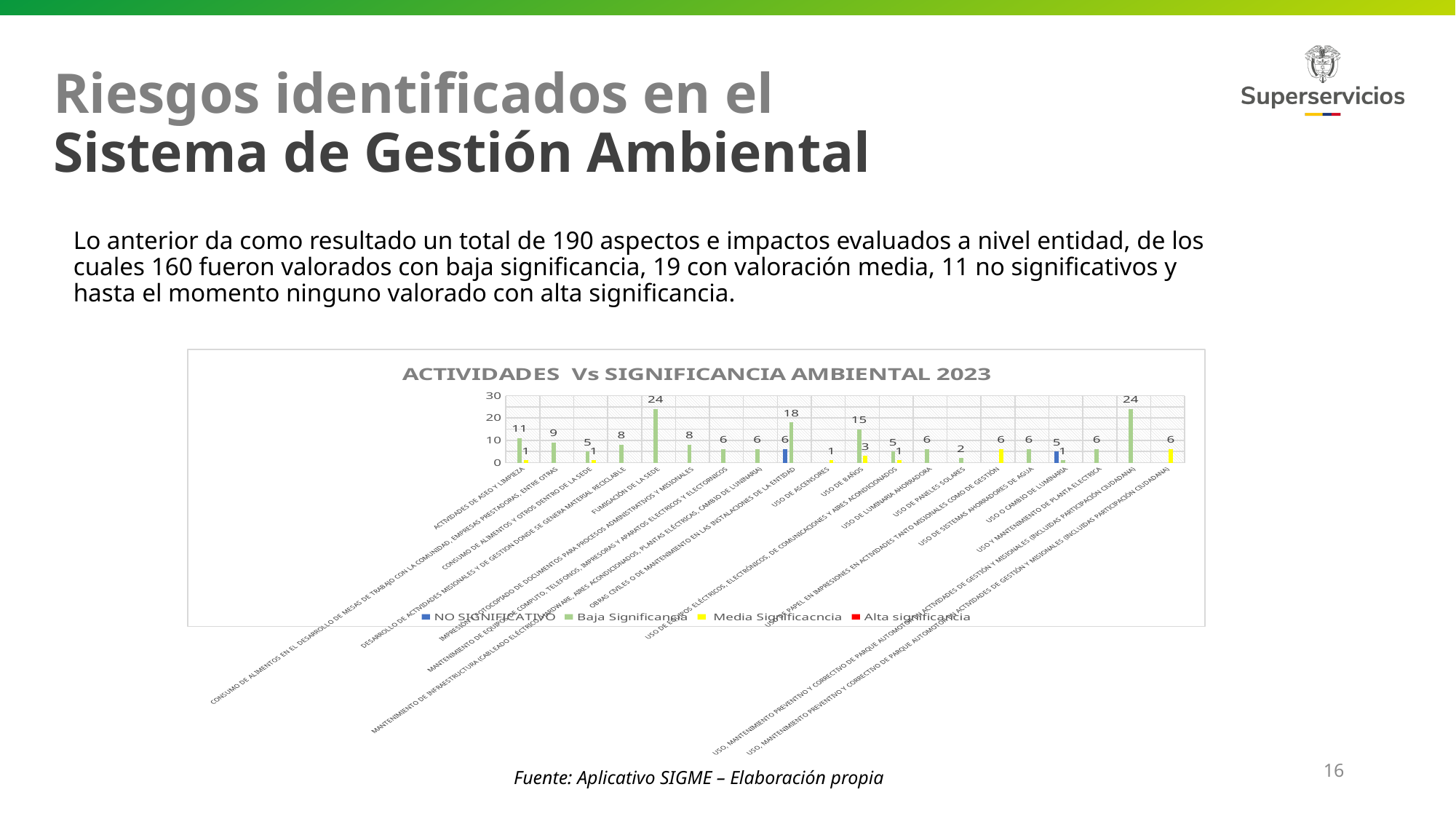
What type of chart is shown on the slide? Bar chart What is the title of the chart? ACTIVIDADES Vs SIGNIFICANCIA AMBIENTAL 2023 What is the Media Significacncia value for USO DE BAÑOS? 3 How many series does the chart legend list? 4 What is the Baja Significancia value for ACTIVIDADES DE ASEO Y LIMPIEZA? 11 What is the highest value labelled on the chart? 24 What is the Baja Significancia value for FUMIGACIÓN DE LA SEDE? 24 Which has a larger Baja Significancia value, FUMIGACIÓN DE LA SEDE or USO DE BAÑOS? FUMIGACIÓN DE LA SEDE What is the difference between the Baja Significancia and Media Significacncia values for USO DE BAÑOS? 12 What is the value shown for USO DE ASCENSORES? 1 What is the Baja Significancia value for USO DE BAÑOS? 15 What is the value shown for USO DE PANELES SOLARES? 2